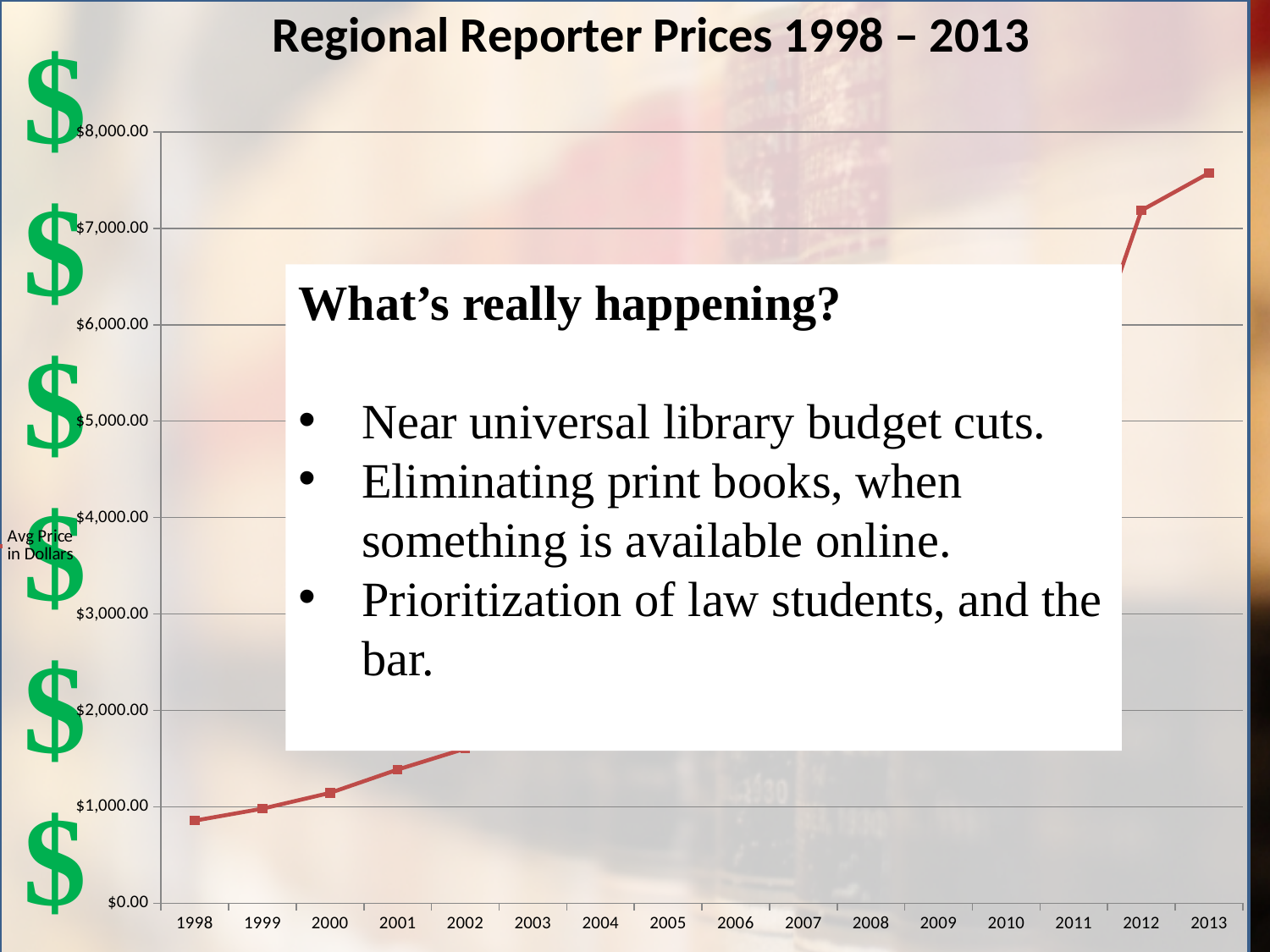
Which year has the lowest plotted price? 1998 What is the title of the chart? Regional Reporter Prices 1998 – 2013 Which year has the highest plotted price? 2013 Is the value for 1998 greater or less than $1,000.00? less Which is larger, the value for 2000 or the value for 2012? 2012 Is the value for 2012 greater or less than $8,000.00? less What label is shown on the vertical axis of the chart? Avg Price in Dollars Is the value for 2013 greater or less than $7,000.00? greater Do the plotted prices rise or fall from 1998 to 2013? rise What kind of chart is shown on the slide? line chart How many years are listed along the x axis of the chart? 16